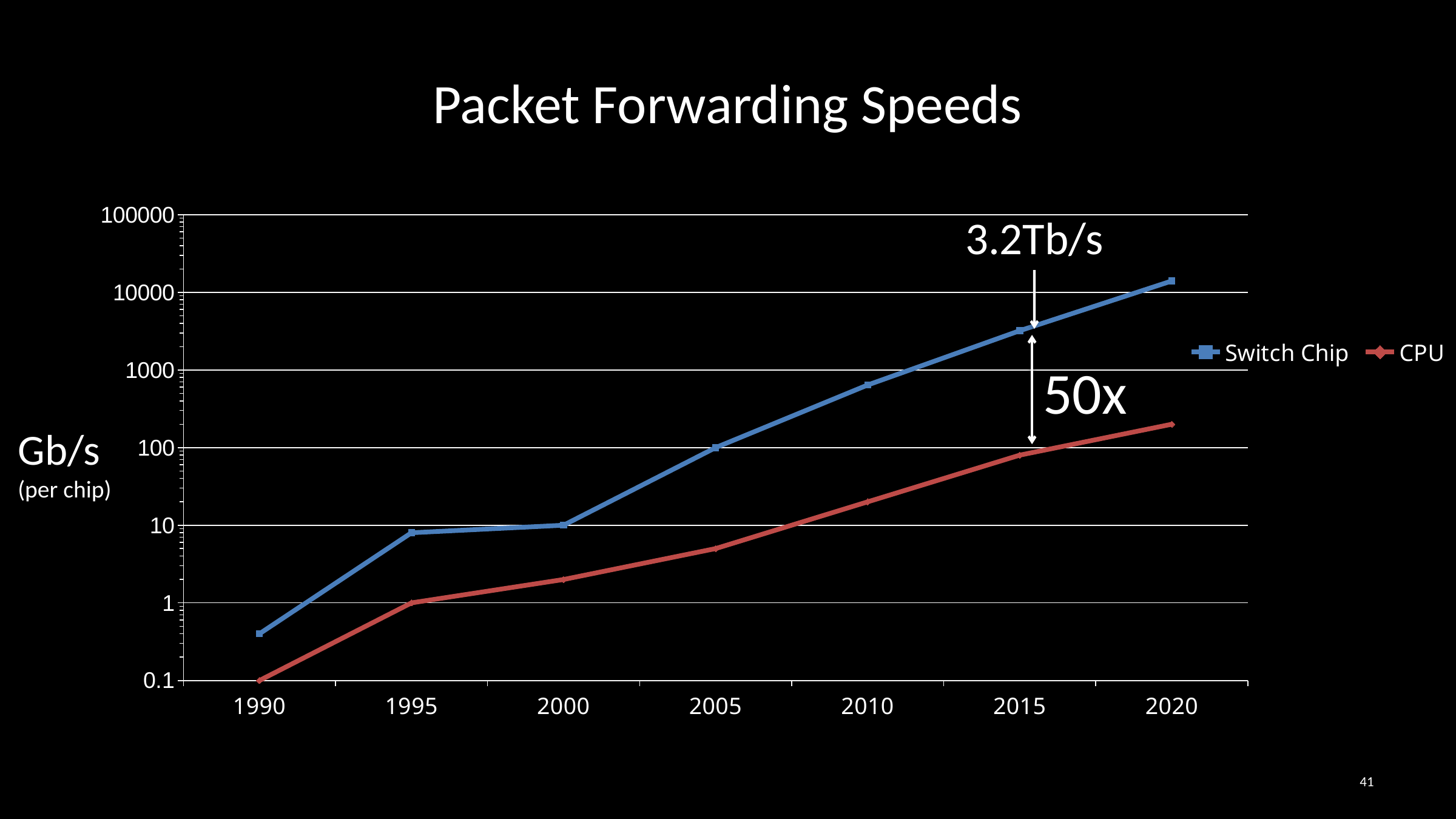
What kind of chart is shown on the slide? line chart What is the CPU value in 1990? 0.1 What is the Switch Chip value in 2000? 10 Is the CPU value for 2020 greater or less than 100? greater What Switch Chip speed is annotated for 2015? 3.2Tb/s How many years are marked along the x axis? 7 What is the CPU value in 1995? 1 What is the Switch Chip value in 2005? 100 In 2010, which series has the higher value, Switch Chip or CPU? Switch Chip What ratio between Switch Chip and CPU is annotated on the chart at 2015? 50x How many series does the legend list? 2 Do the Switch Chip values rise or fall from 1990 to 2020? rise